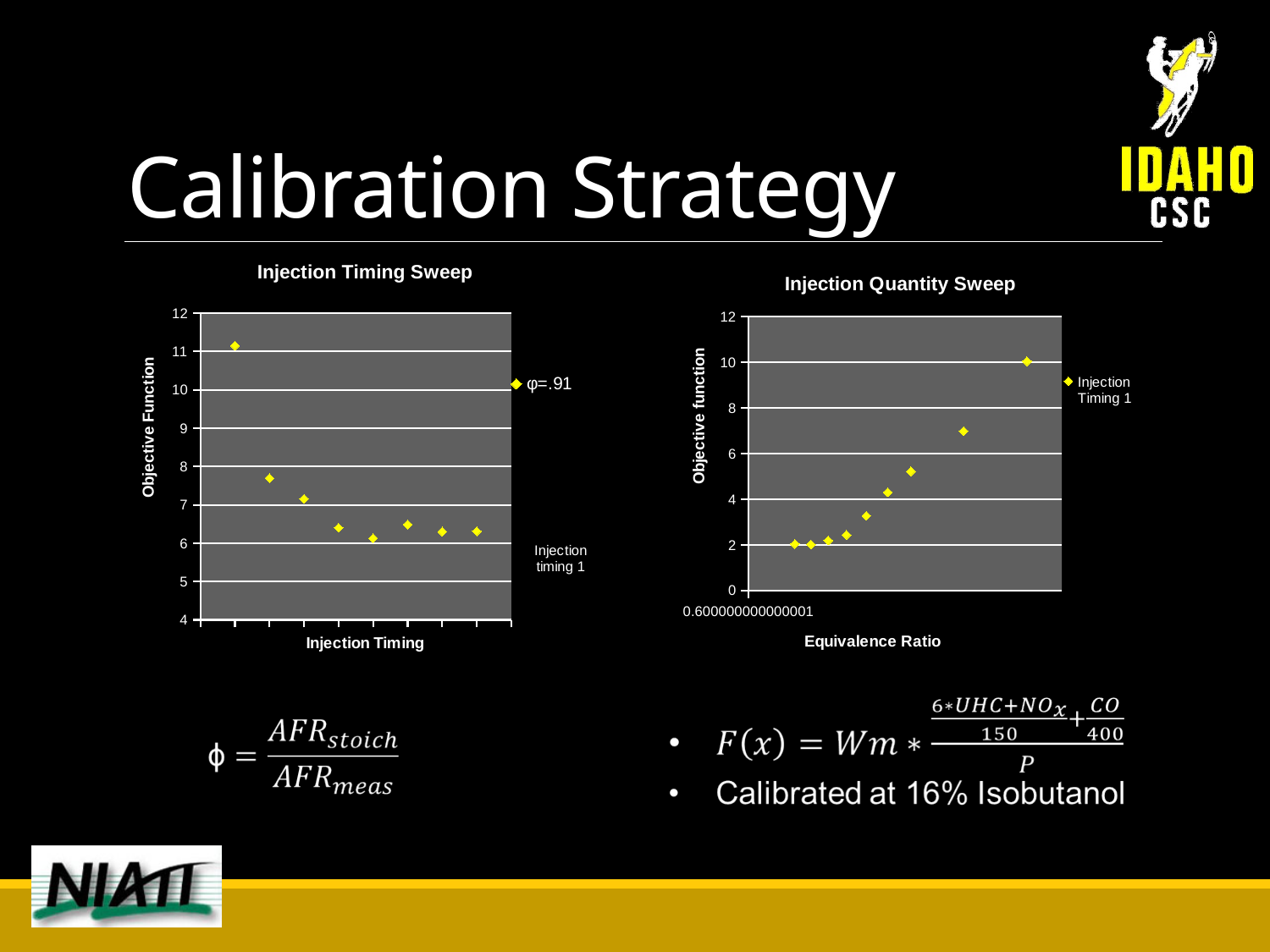
What series name does the legend of the Injection Quantity Sweep chart show? Injection Timing 1 What kind of chart is the Injection Quantity Sweep chart? scatter chart What is the x-axis label of the Injection Quantity Sweep chart? Equivalence Ratio What kind of chart is the Injection Timing Sweep chart? scatter chart How many data points are plotted in the Injection Quantity Sweep chart? 9 How many data points are plotted in the Injection Timing Sweep chart? 8 In the Injection Quantity Sweep chart, which point is higher: the leftmost point or the rightmost point? the rightmost point In the Injection Timing Sweep chart, is the value of the leftmost point greater or less than 10? greater In the Injection Quantity Sweep chart, is the value of the rightmost point greater or less than 8? greater In the Injection Timing Sweep chart, do the objective function values generally rise or fall from left to right along the x axis? fall In the Injection Quantity Sweep chart, do the objective function values rise or fall as the equivalence ratio increases along the x axis? rise In the Injection Quantity Sweep chart, is the value of the leftmost point greater or less than 4? less